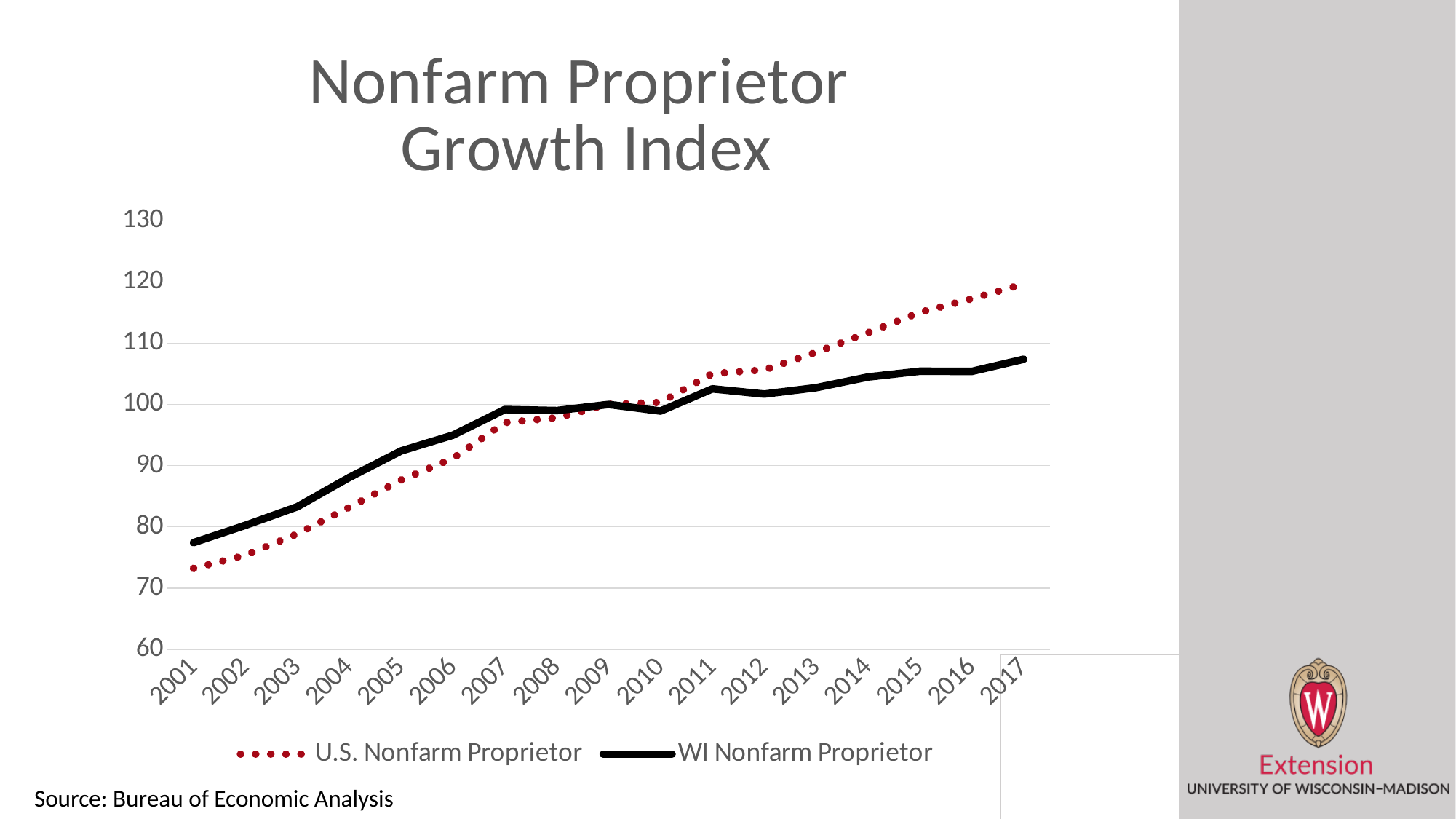
How many years are shown on the x axis? 17 Is the value for WI Nonfarm Proprietor in 2017 greater or less than 110? less Which series is drawn with a dotted red line? U.S. Nonfarm Proprietor Does the U.S. Nonfarm Proprietor series generally rise or fall from 2001 to 2017? rise How many series does the legend list? 2 What kind of chart is shown on the slide? line chart In 2017, which series has the higher value, U.S. Nonfarm Proprietor or WI Nonfarm Proprietor? U.S. Nonfarm Proprietor What is the title of the chart? Nonfarm Proprietor Growth Index Is the value for WI Nonfarm Proprietor in 2005 greater or less than 90? greater Is the value for U.S. Nonfarm Proprietor in 2001 greater or less than 80? less In 2003, which series has the higher value, U.S. Nonfarm Proprietor or WI Nonfarm Proprietor? WI Nonfarm Proprietor